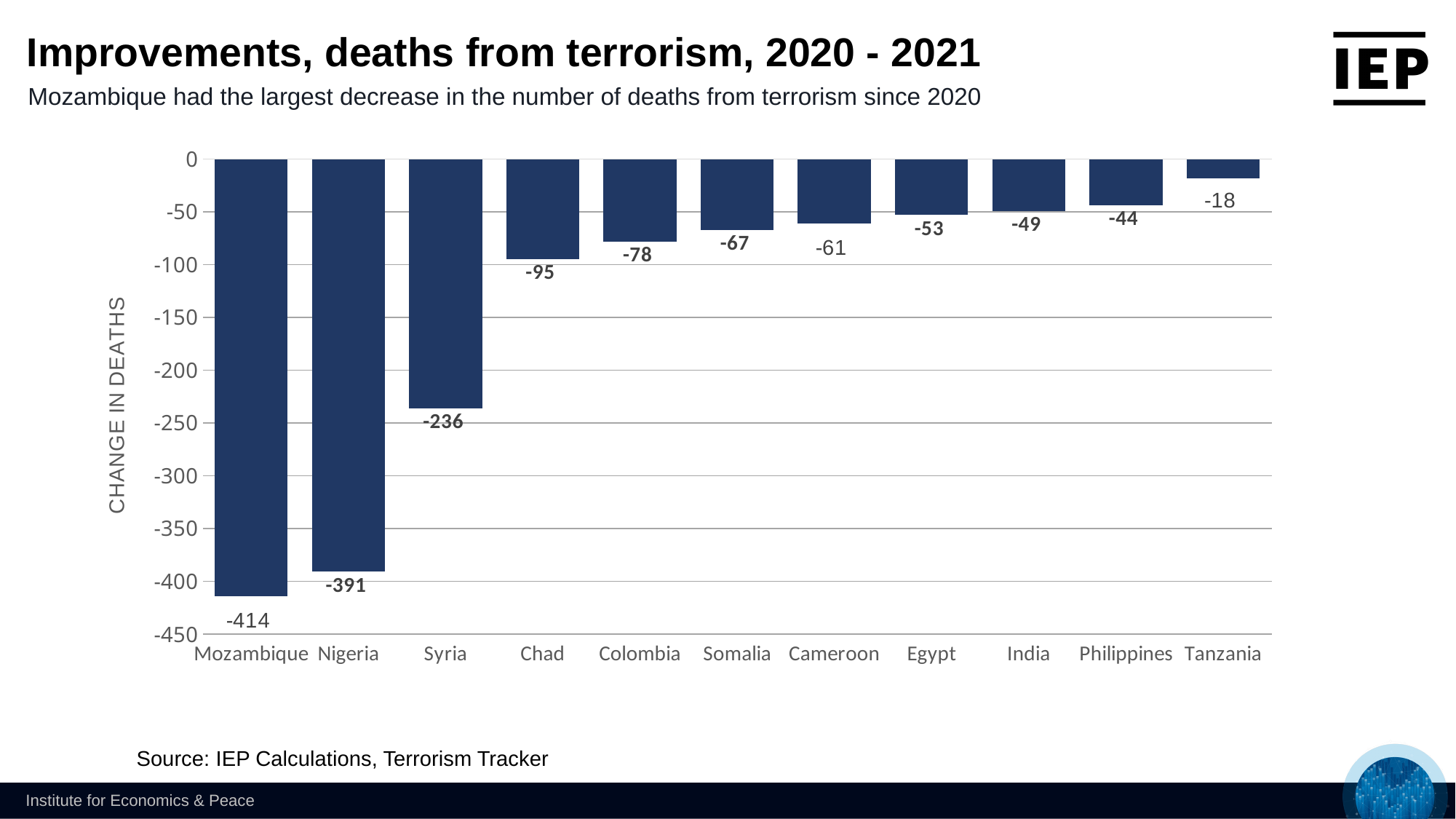
What is the label of the vertical axis? CHANGE IN DEATHS What is the change in deaths for Tanzania? -18 Which country has the largest decrease in deaths from terrorism? Mozambique How many countries are shown in the chart? 11 Which country has the smallest decrease in deaths from terrorism? Tanzania Which country has a larger decrease in deaths, Chad or Colombia? Chad Do the bars get shorter or longer moving from left to right along the x axis? Shorter What is the change in deaths for Mozambique? -414 What is the change in deaths for Cameroon? -61 What type of chart is shown on the slide? Bar chart What is the difference between the values for Mozambique and Nigeria? 23 What is the change in deaths for Syria? -236